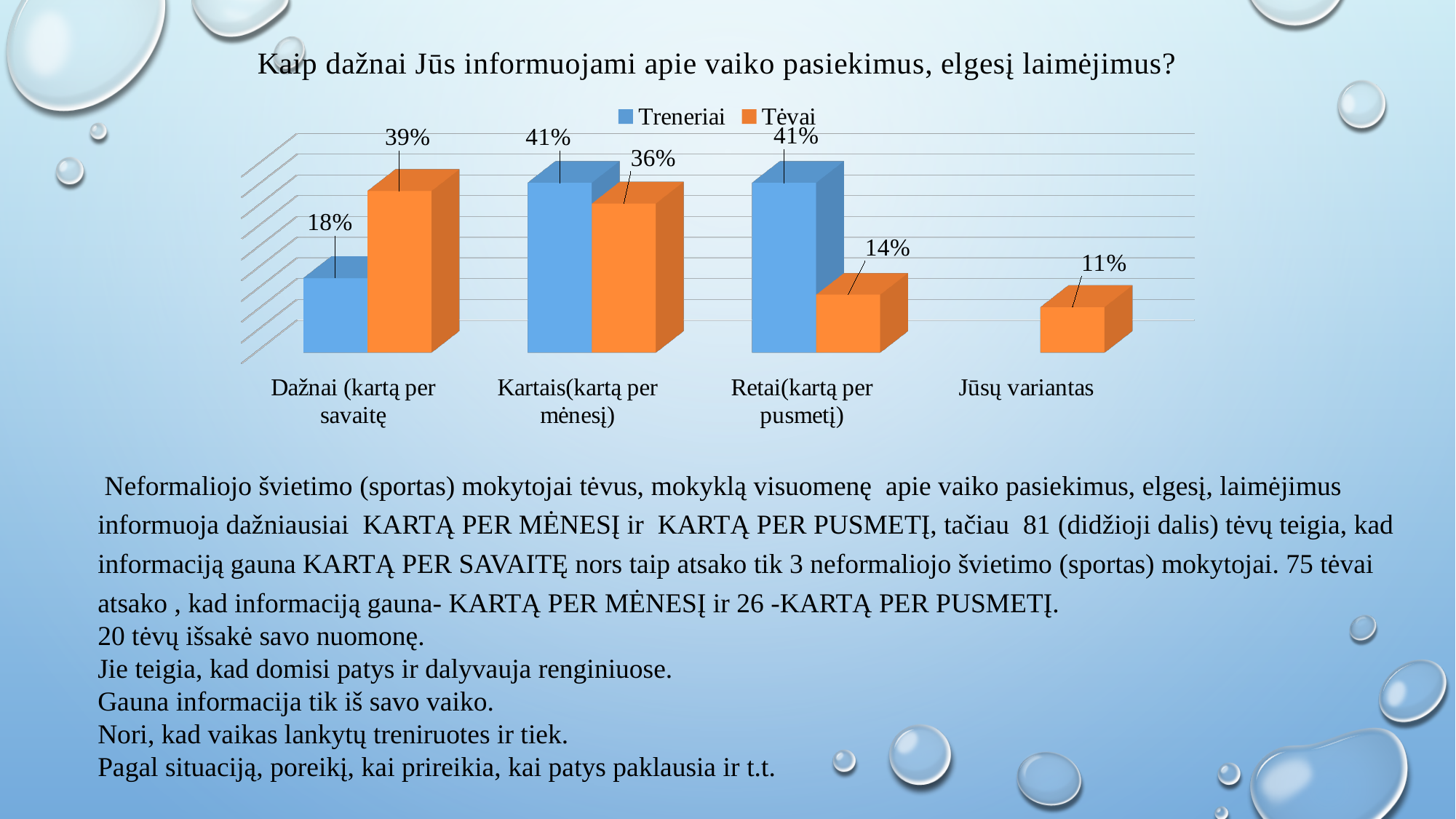
How many series does the legend list? 2 For Retai (kartą per pusmetį), which series has the larger value, Treneriai or Tėvai? Treneriai What is the Tėvai value for Retai (kartą per pusmetį)? 14% What is the Tėvai value for Jūsų variantas? 11% What is the Tėvai value for Dažnai (kartą per savaitę)? 39% How many categories are shown on the x axis? 4 Which category has the highest Tėvai value? Dažnai (kartą per savaitę) Which category has the lowest Tėvai value? Jūsų variantas What is the Tėvai value for Kartais (kartą per mėnesį)? 36% What kind of chart is shown on the slide? Bar chart What is the Treneriai value for Dažnai (kartą per savaitę)? 18% What is the difference between the Tėvai and Treneriai values for Dažnai (kartą per savaitę)? 21%